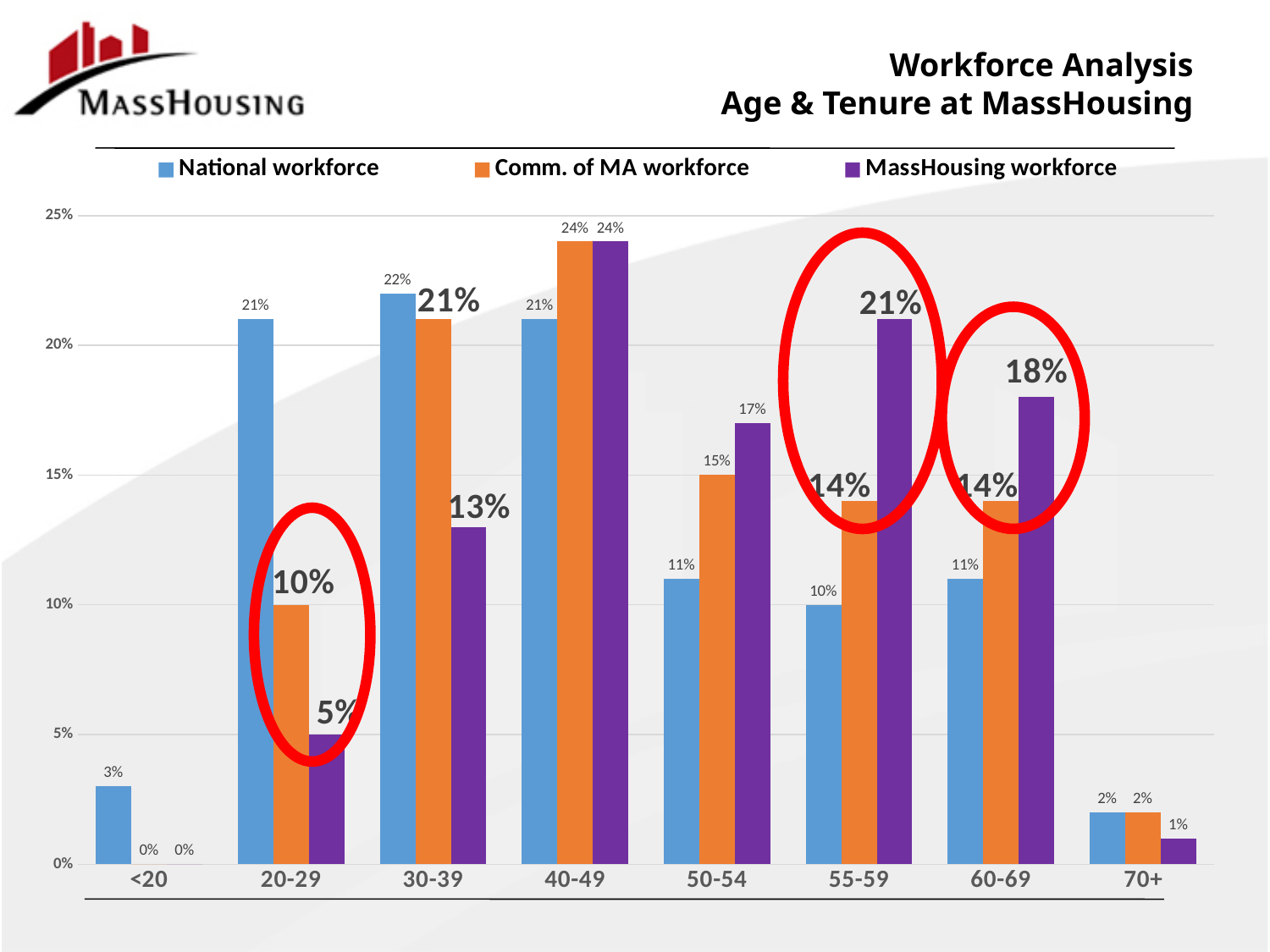
How many age groups are shown on the x axis? 8 Which age group has the lowest National workforce value? 70+ What kind of chart is shown on the slide? Bar chart What is the Comm. of MA workforce value for the 20-29 age group? 10% What is the National workforce value for the 30-39 age group? 22% Which series is shown in purple in the legend? MassHousing workforce Which age group has the highest MassHousing workforce value? 40-49 What is the difference between the MassHousing workforce and the National workforce values for the 20-29 age group? 16% What is the MassHousing workforce value for the 70+ age group? 1% What is the MassHousing workforce value for the 55-59 age group? 21% How many series does the legend list? 3 For the 60-69 age group, which is larger: the MassHousing workforce value or the Comm. of MA workforce value? MassHousing workforce